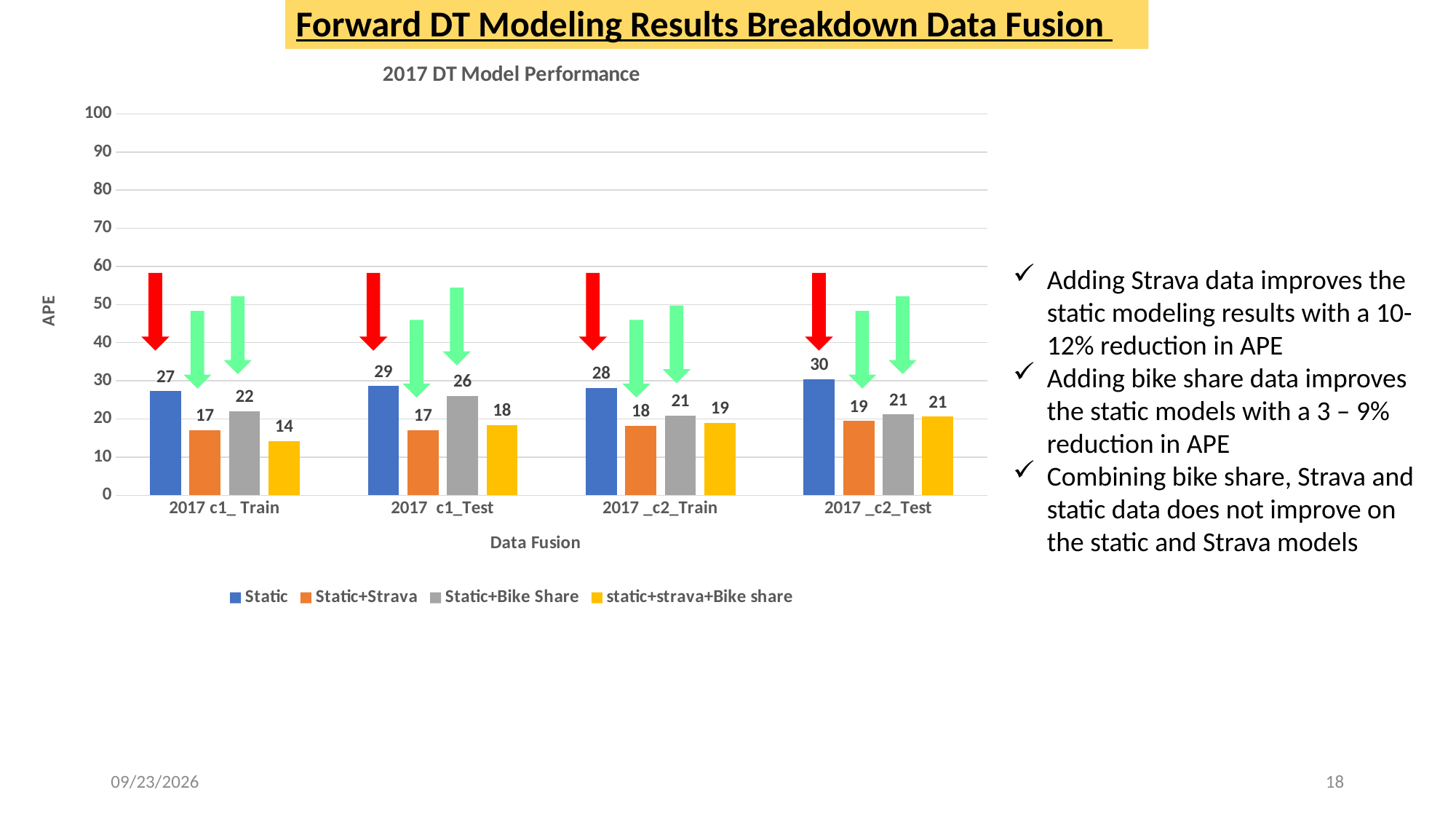
What is the title of the chart? 2017 DT Model Performance Which category has the lowest static+strava+Bike share APE value? 2017 c1_ Train What is the Static APE value for 2017 c1_ Train? 27 What kind of chart is shown on the slide? Bar chart What is the static+strava+Bike share APE value for 2017 c1_ Train? 14 What is the difference between the Static and Static+Strava APE values for 2017 c1_Test? 12 How many series does the legend list? 4 Which is larger for 2017 _c2_Train: the Static+Bike Share value or the static+strava+Bike share value? Static+Bike Share Which category has the highest Static APE value? 2017 _c2_Test What is the Static+Bike Share APE value for 2017 c1_Test? 26 How many categories are shown on the x axis? 4 What is the Static+Strava APE value for 2017 _c2_Test? 19